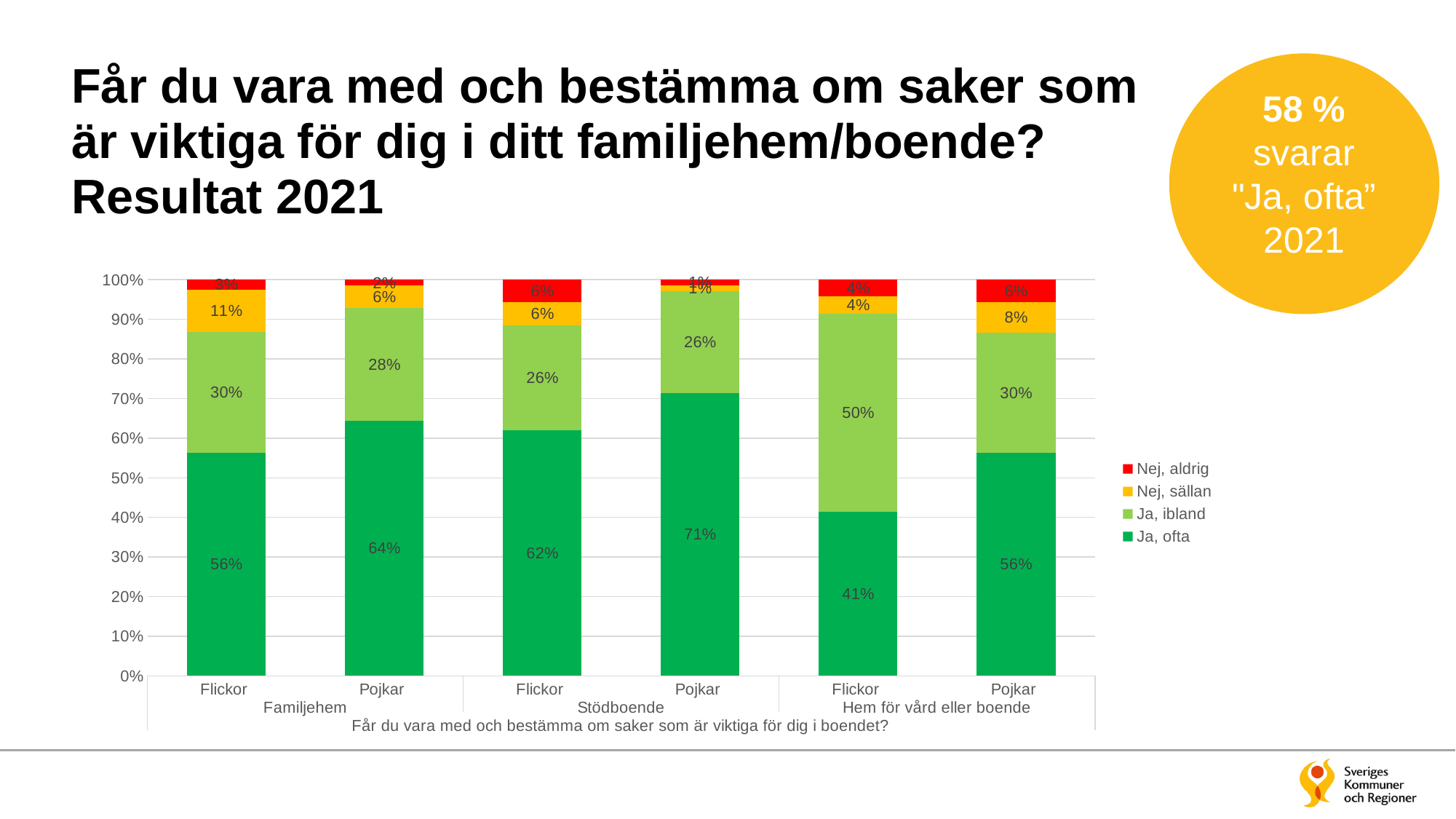
What is the "Ja, ibland" value for Flickor in Hem för vård eller boende? 50% What is the "Nej, sällan" value for Pojkar in Hem för vård eller boende? 8% How many series does the legend list? 4 How many bars are plotted in the chart? 6 What kind of chart is shown on the slide? stacked bar chart Which bar has the lowest "Ja, ofta" value? Flickor, Hem för vård eller boende What is the "Nej, sällan" value for Flickor in Familjehem? 11% Which is larger: the "Ja, ofta" value for Flickor in Stödboende or for Pojkar in Hem för vård eller boende? Flickor in Stödboende What is the difference between the "Ja, ofta" values for Pojkar and Flickor in Familjehem? 8% Which bar has the highest "Ja, ofta" value? Pojkar, Stödboende Which legend entry is shown in red? Nej, aldrig What is the "Ja, ofta" value for Flickor in Familjehem? 56%